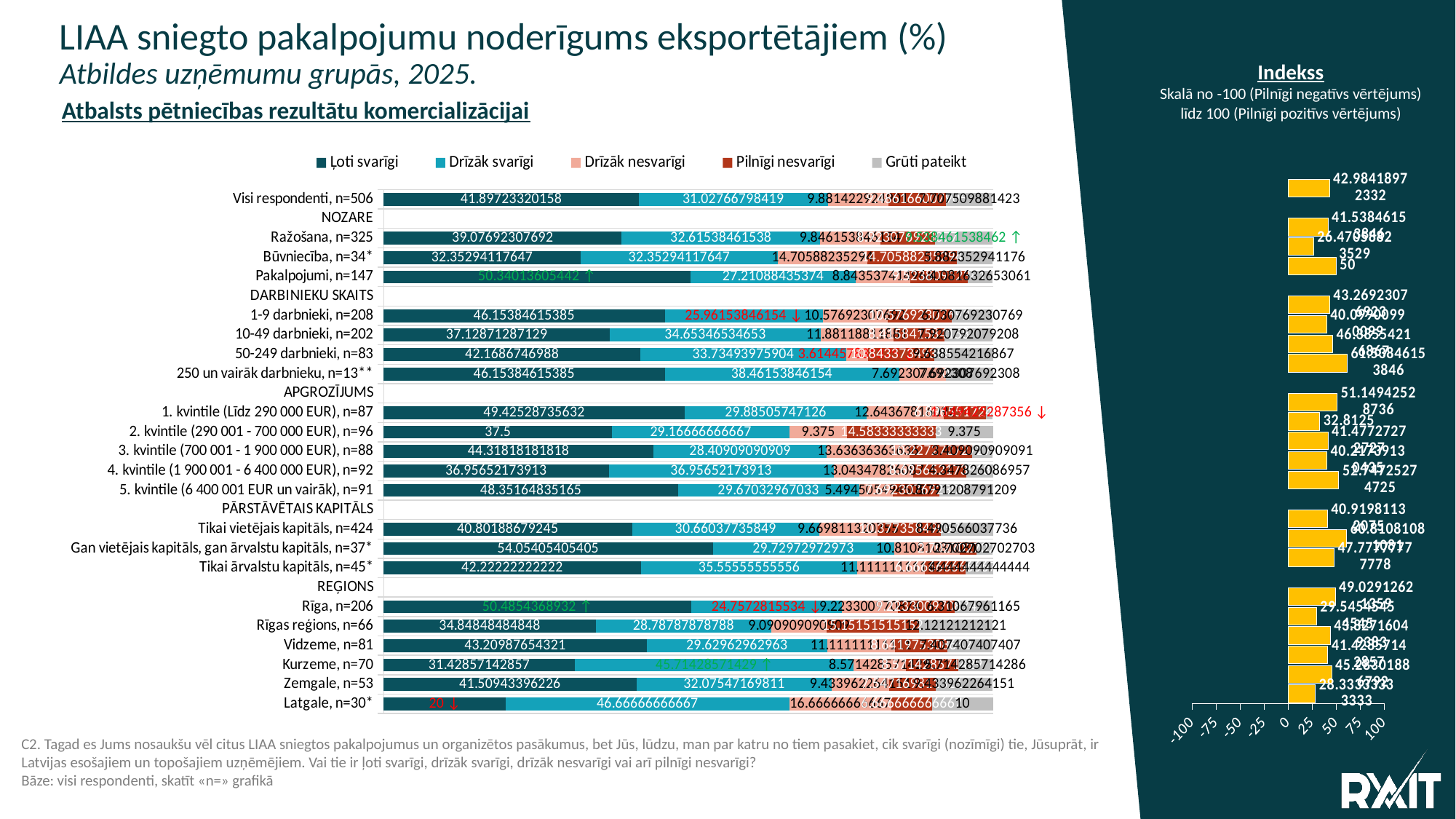
In the main chart, which category has the highest 'Ļoti svarīgi' value? Gan vietējais kapitāls, gan ārvalstu kapitāls, n=37* In the main chart, what is the 'Ļoti svarīgi' value for 'Visi respondenti, n=506'? 41.89723320158 In the 'Indekss' chart on the right, what is the value for 'Pakalpojumi, n=147'? 50 In the 'Indekss' chart on the right, is the value for 'Būvniecība, n=34*' greater or less than 50? less In the main chart, which has the larger 'Ļoti svarīgi' value: 'Pakalpojumi, n=147' or 'Ražošana, n=325'? Pakalpojumi, n=147 How many series does the legend of the main chart list? 5 In the 'Indekss' chart on the right, what is the value for '2. kvintile (290 001 - 700 000 EUR), n=96'? 32.8125 In the main chart, which category has the lowest 'Ļoti svarīgi' value? Latgale, n=30* In the main chart, what is the 'Pilnīgi nesvarīgi' value for '2. kvintile (290 001 - 700 000 EUR), n=96'? 14.58333333333 In the main chart, what is the difference between the 'Drīzāk svarīgi' and 'Ļoti svarīgi' values for 'Latgale, n=30*'? 26.66666666667 What kind of chart is the main chart on the left of the slide? bar chart In the main chart, what is the 'Drīzāk svarīgi' value for 'Kurzeme, n=70'? 45.71428571429